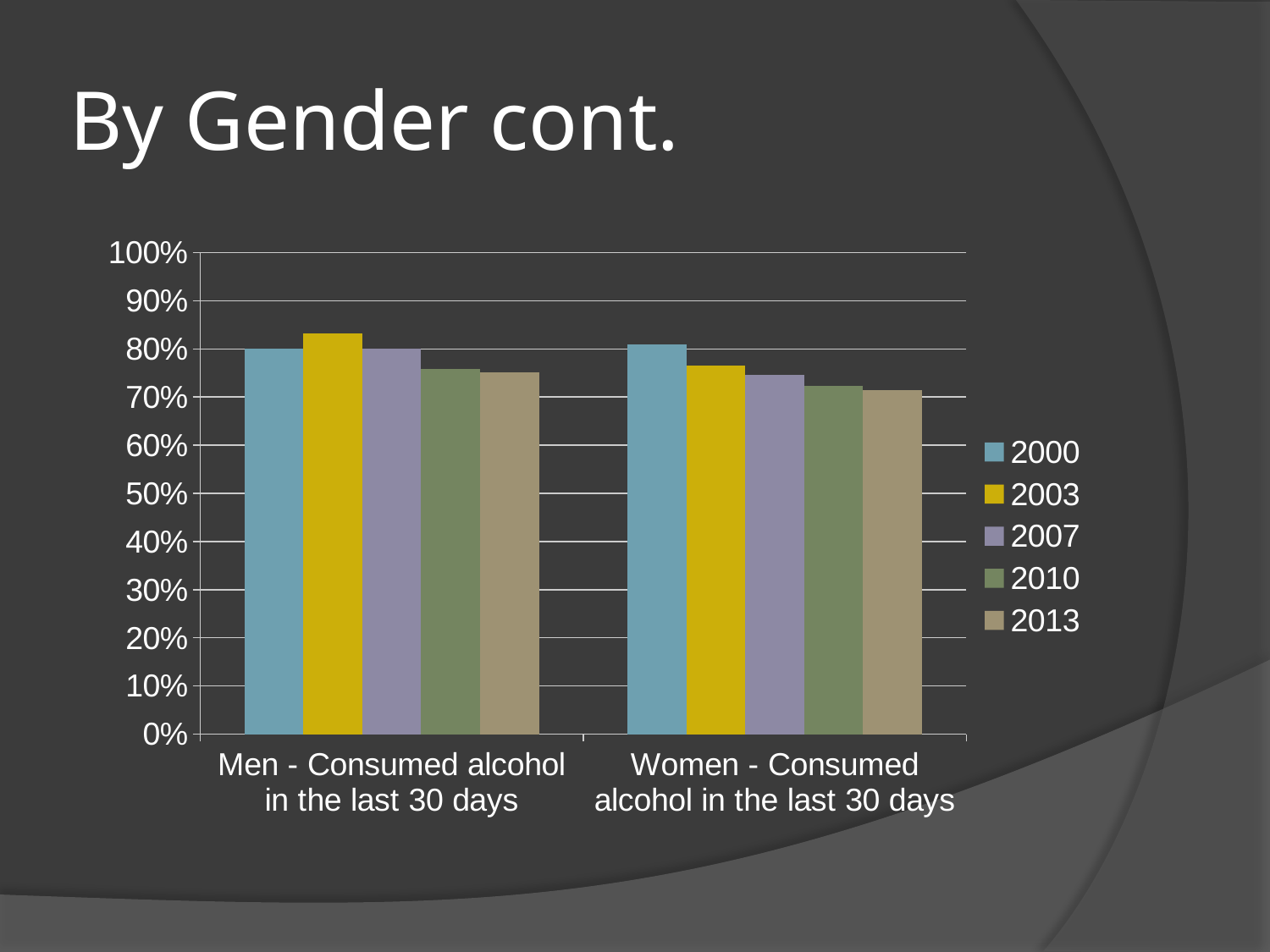
Is the 2010 value for Men - Consumed alcohol in the last 30 days greater or less than 80%? less Is the 2003 value for Men - Consumed alcohol in the last 30 days greater or less than 80%? greater For Women - Consumed alcohol in the last 30 days, do the values rise or fall from 2000 to 2013? fall What is the title of the slide? By Gender cont. How many series does the legend list? 5 Which year has the highest bar for Women - Consumed alcohol in the last 30 days? 2000 Is the 2010 value for Women - Consumed alcohol in the last 30 days greater or less than 70%? greater What kind of chart is shown on the slide? bar chart How many categories are shown on the x axis? 2 Which is larger: the 2003 value for Men or the 2003 value for Women? Men Which year has the highest bar for Men - Consumed alcohol in the last 30 days? 2003